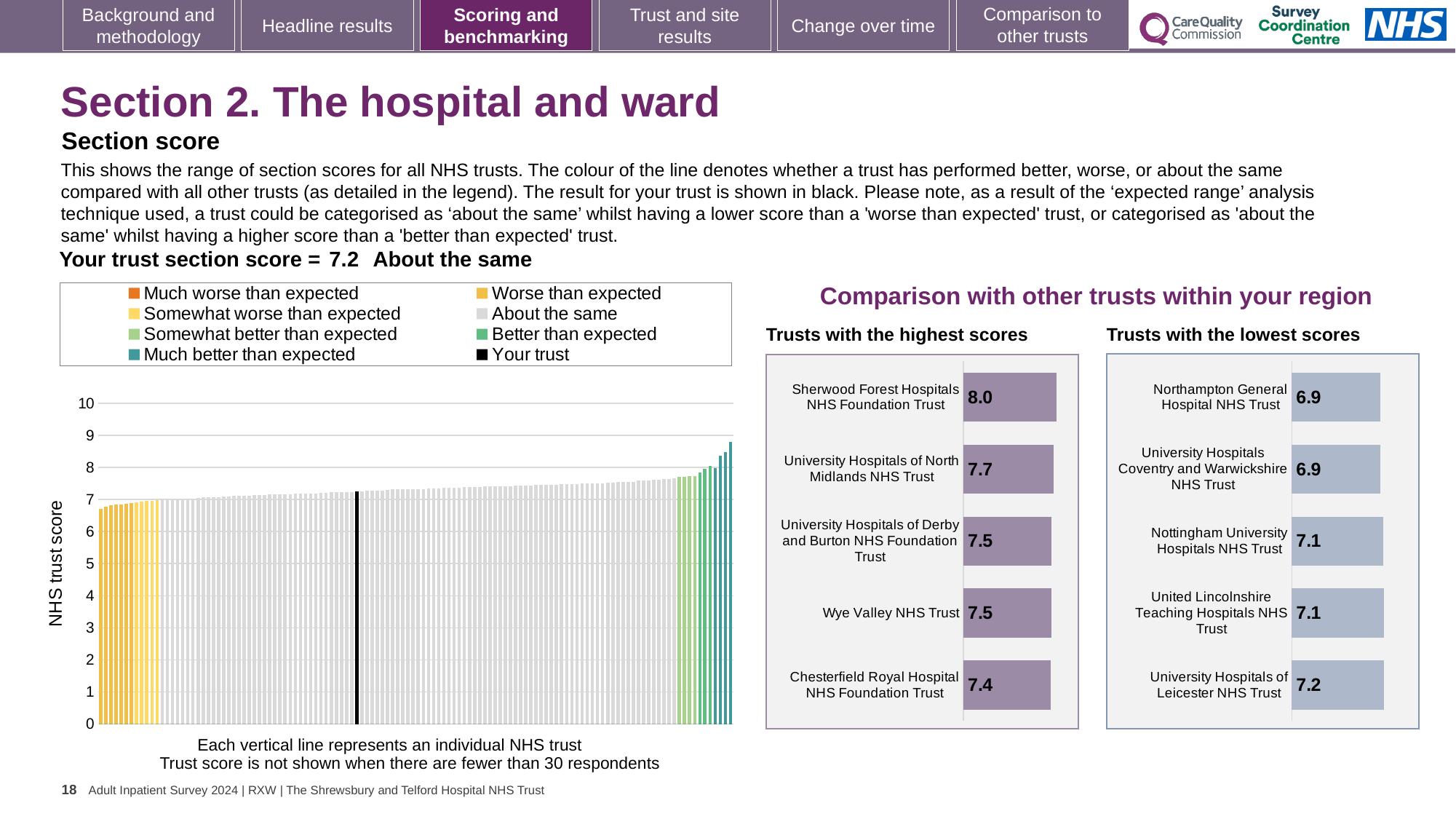
In the NHS trust score chart on the left, is the value of the rightmost bar greater or less than 8? greater In the 'Trusts with the lowest scores' chart, which trust has the highest score? University Hospitals of Leicester NHS Trust In the 'Trusts with the highest scores' chart, which trust has the highest score? Sherwood Forest Hospitals NHS Foundation Trust What kind of chart is the NHS trust score chart on the left of the slide? Bar chart In the 'Trusts with the highest scores' chart, what is the difference between the scores of Sherwood Forest Hospitals NHS Foundation Trust and Chesterfield Royal Hospital NHS Foundation Trust? 0.6 In the 'Trusts with the lowest scores' chart, what is the difference between the scores of University Hospitals of Leicester NHS Trust and Northampton General Hospital NHS Trust? 0.3 How many entries does the legend of the NHS trust score chart on the left list? 8 In the 'Trusts with the lowest scores' chart, what is the score for Nottingham University Hospitals NHS Trust? 7.1 How many trusts are listed in the 'Trusts with the lowest scores' chart? 5 In the 'Trusts with the highest scores' chart, which has the larger score: Sherwood Forest Hospitals NHS Foundation Trust or University Hospitals of North Midlands NHS Trust? Sherwood Forest Hospitals NHS Foundation Trust In the 'Trusts with the highest scores' chart, what is the score for Sherwood Forest Hospitals NHS Foundation Trust? 8.0 In the 'Trusts with the highest scores' chart, what is the score for Wye Valley NHS Trust? 7.5